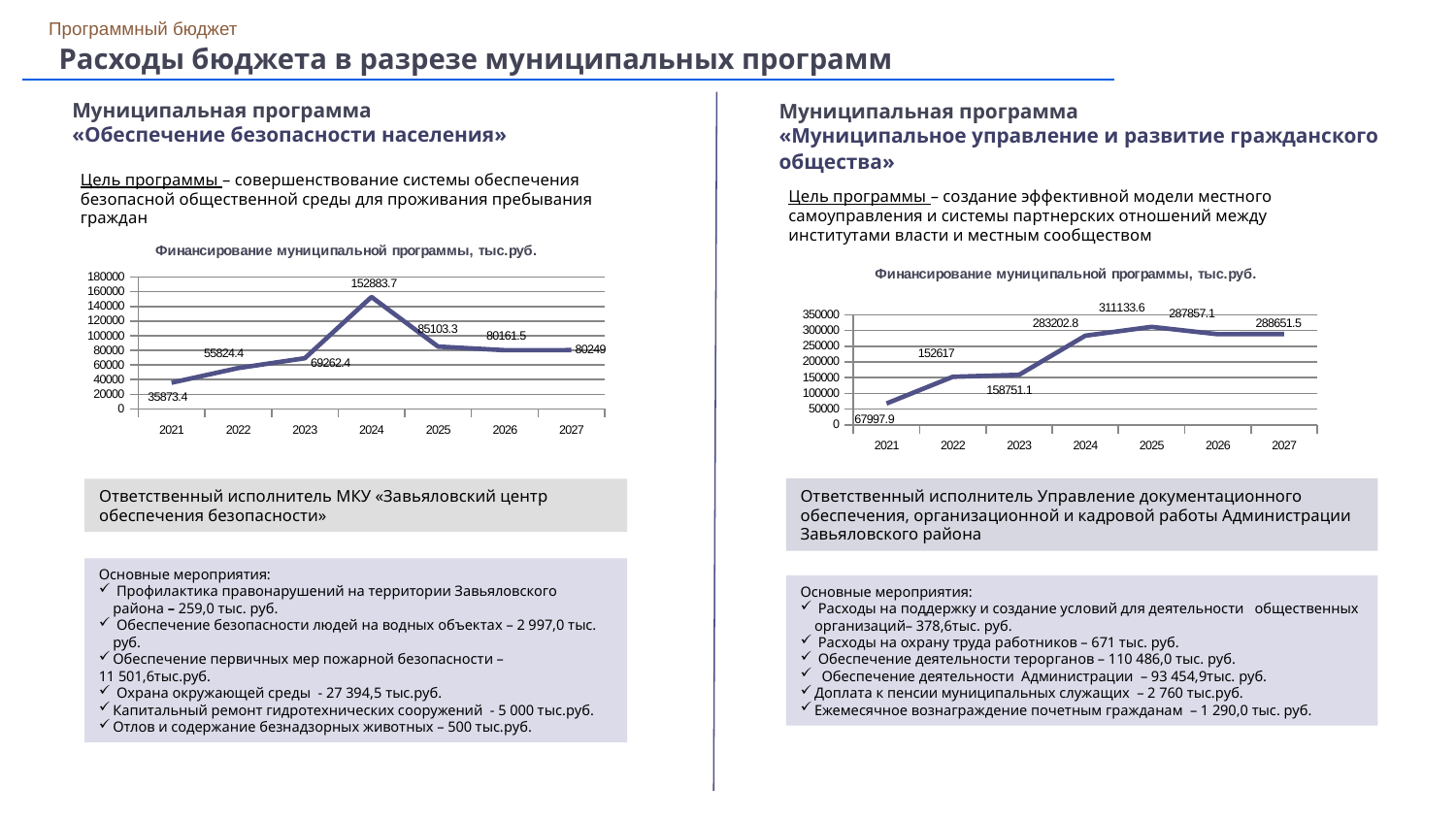
In the right chart (Муниципальное управление и развитие гражданского общества), which year has the highest value? 2025 In the left chart (Обеспечение безопасности населения), which year has the highest value? 2024 In the right chart (Муниципальное управление и развитие гражданского общества), what is the value for 2021? 67997.9 In the left chart (Обеспечение безопасности населения), what is the value for 2024? 152883.7 What type of chart is used on the right side of the slide? Line chart In the right chart (Муниципальное управление и развитие гражданского общества), what is the value for 2025? 311133.6 In the left chart (Обеспечение безопасности населения), what is the difference between the 2024 and 2025 values? 67780.4 In the left chart (Обеспечение безопасности населения), how many years are plotted? 7 In the right chart (Муниципальное управление и развитие гражданского общества), what is the difference between the 2024 and 2023 values? 124451.7 In the left chart (Обеспечение безопасности населения), what is the value for 2021? 35873.4 In the left chart (Обеспечение безопасности населения), which year has the lowest value? 2021 In the right chart (Муниципальное управление и развитие гражданского общества), which is larger, the value for 2022 or 2023? 2023